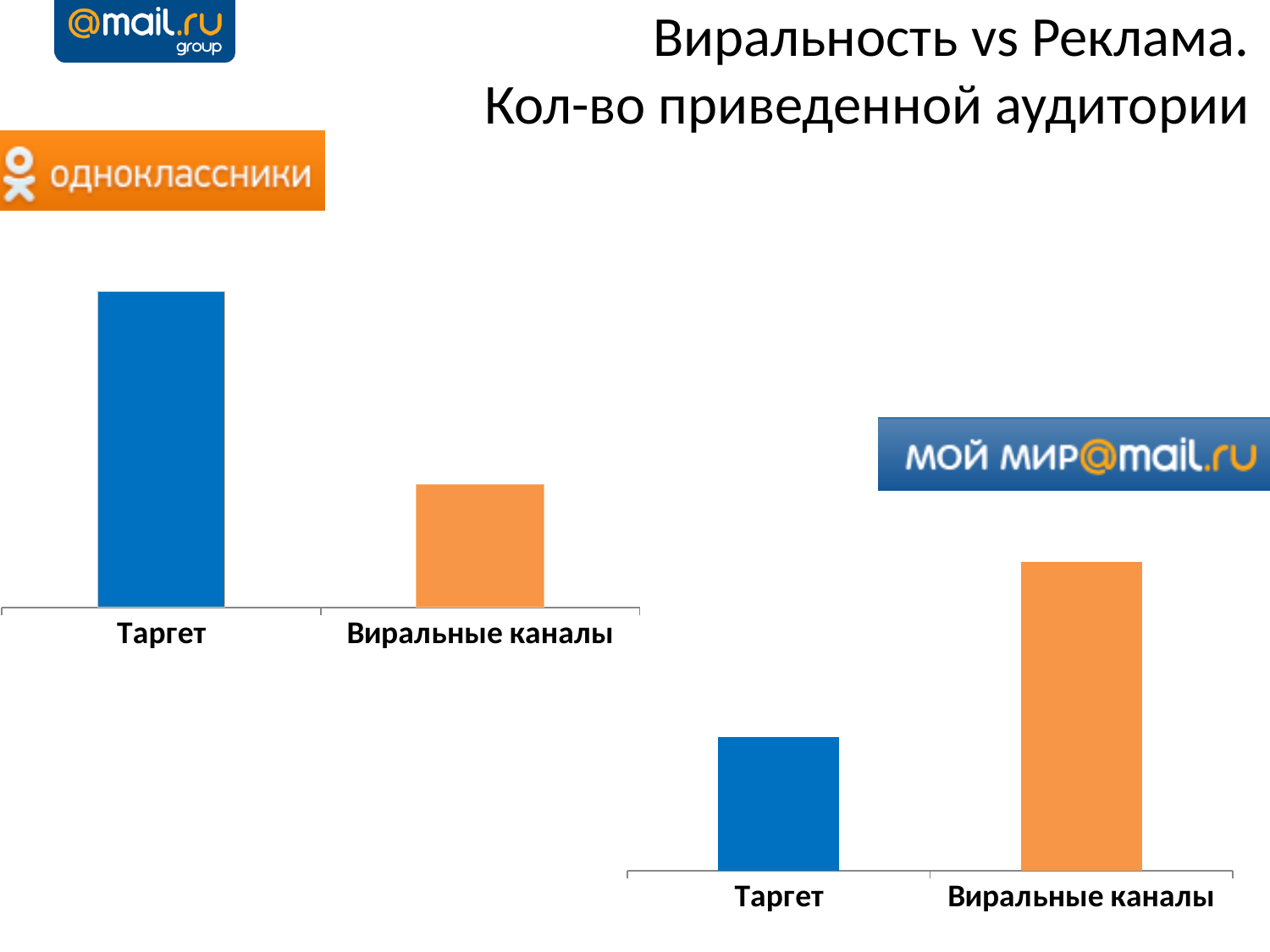
In the left chart (Одноклассники), how many categories are shown? 2 In the right chart (Мой Мир), is the bar for Таргет larger or smaller than the bar for Виральные каналы? smaller What kind of chart is the left chart (under the Одноклассники logo)? bar chart What kind of chart is the right chart (under the Мой Мир logo)? bar chart In the right chart (Мой Мир), what colour is the bar for Виральные каналы? orange In the left chart (Одноклассники), which category has the highest bar? Таргет In the right chart (Мой Мир), how many categories are shown? 2 In the left chart (Одноклассники), what colour is the bar for Таргет? blue In the right chart (Мой Мир), which category has the highest bar? Виральные каналы In the left chart (Одноклассники), is the bar for Таргет larger or smaller than the bar for Виральные каналы? larger In the left chart (Одноклассники), which category has the lowest bar? Виральные каналы In the right chart (Мой Мир), which category has the lowest bar? Таргет